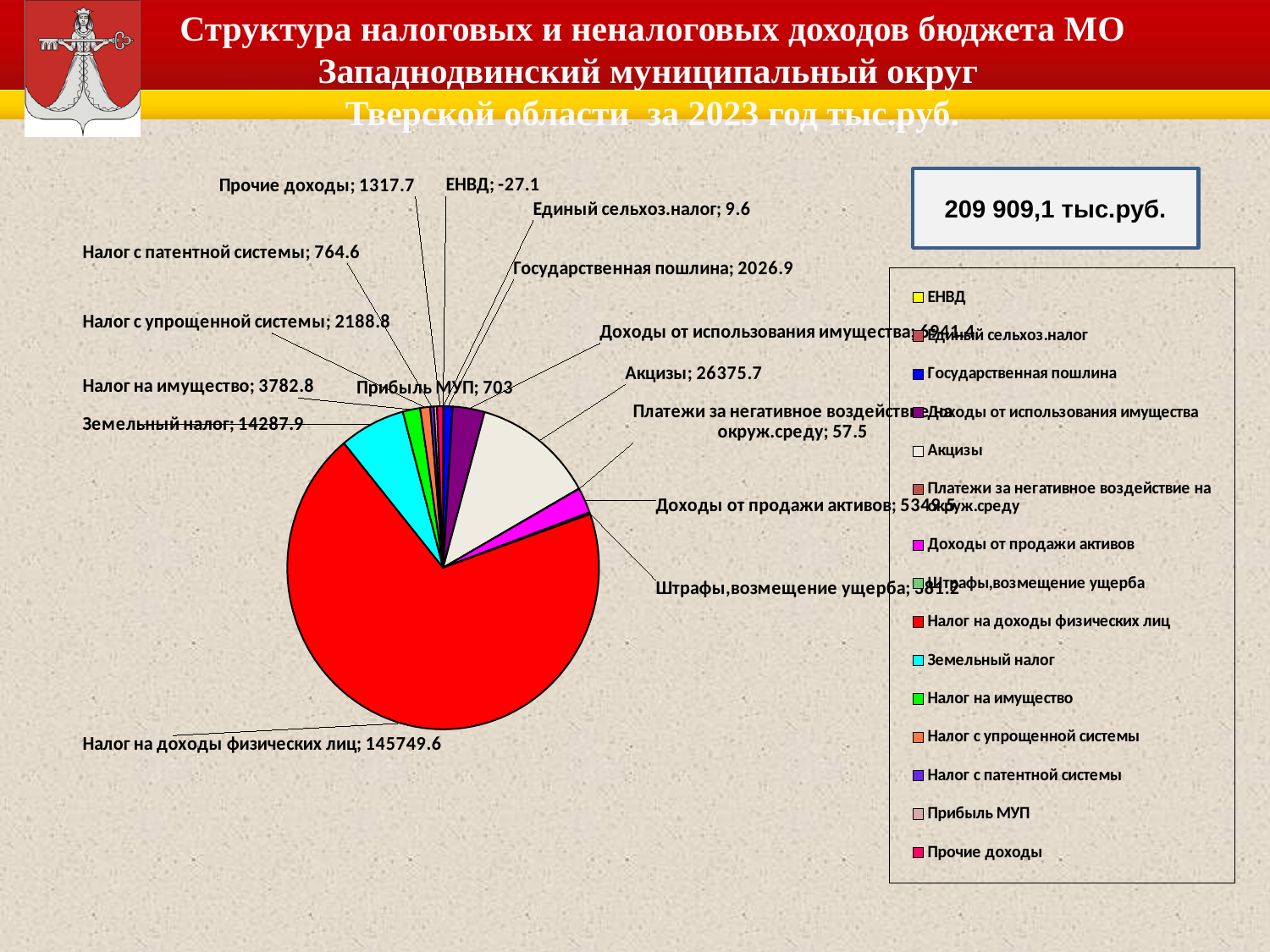
Which is larger: Государственная пошлина or Налог с упрощенной системы? Налог с упрощенной системы What kind of chart is shown on the slide? Pie chart What is the difference between Земельный налог and Налог на имущество? 10505.1 What is the value for Платежи за негативное воздействие на окруж.среду? 57.5 Which category has the largest value in the pie chart? Налог на доходы физических лиц What is the value for Налог на доходы физических лиц? 145749.6 How many entries does the legend list? 15 What is the value for Акцизы? 26375.7 What is the value for Земельный налог? 14287.9 Which category has the smallest value in the pie chart? ЕНВД What is the difference between Акцизы and Земельный налог? 12087.8 What is the value for Прибыль МУП? 703